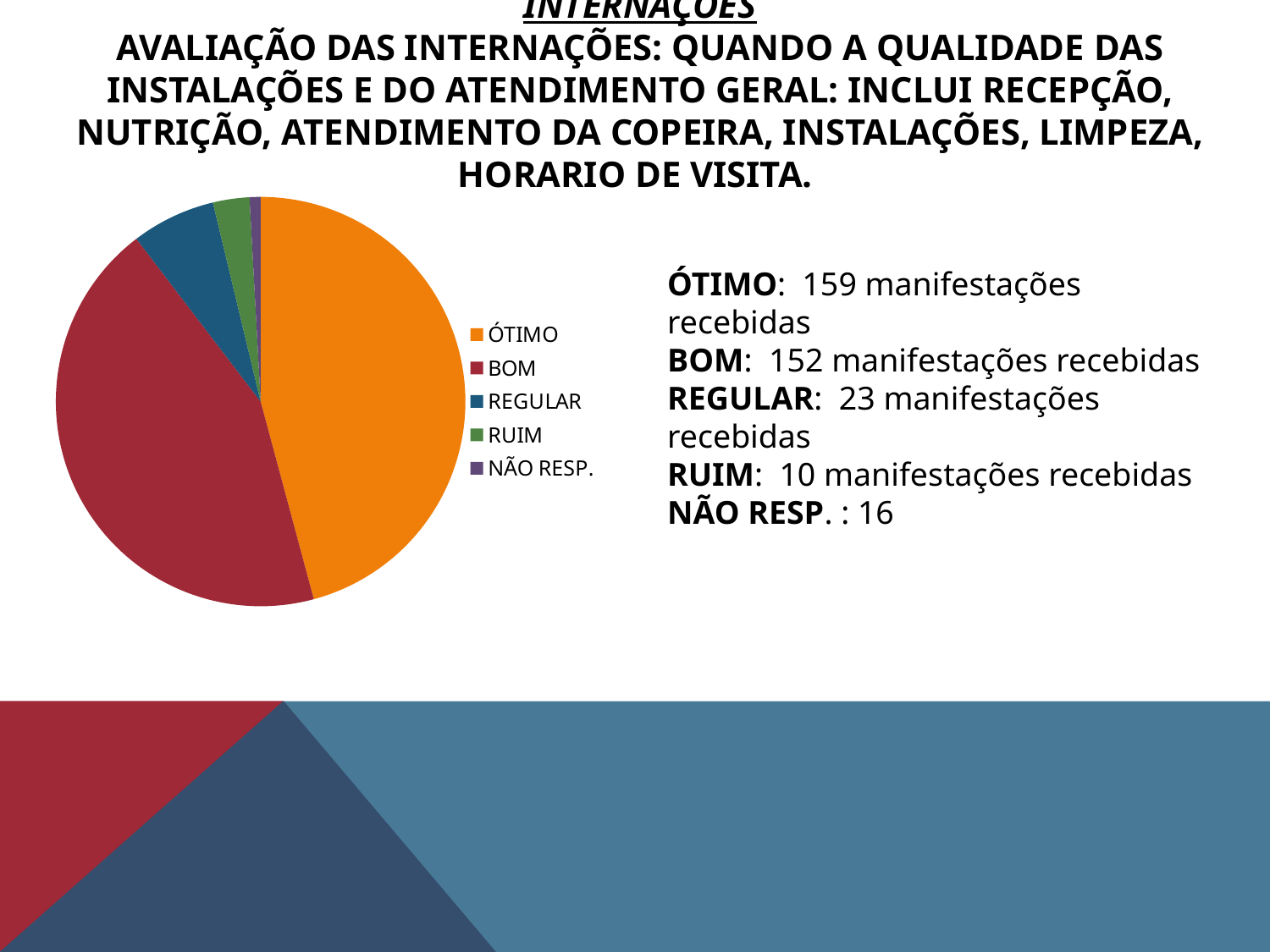
How many manifestações recebidas are reported for BOM? 152 Which category has the highest number of manifestações recebidas? ÓTIMO What value is given for NÃO RESP.? 16 How many categories does the pie chart have? 5 What colour is the ÓTIMO slice in the pie chart? orange How many manifestações recebidas are reported for ÓTIMO? 159 What kind of chart is shown on the slide? pie chart How many manifestações recebidas are reported for RUIM? 10 How many manifestações recebidas are reported for REGULAR? 23 How many entries does the legend of the pie chart list? 5 What is the difference between the number of manifestações for ÓTIMO and for BOM? 7 Which has more manifestações recebidas, BOM or REGULAR? BOM